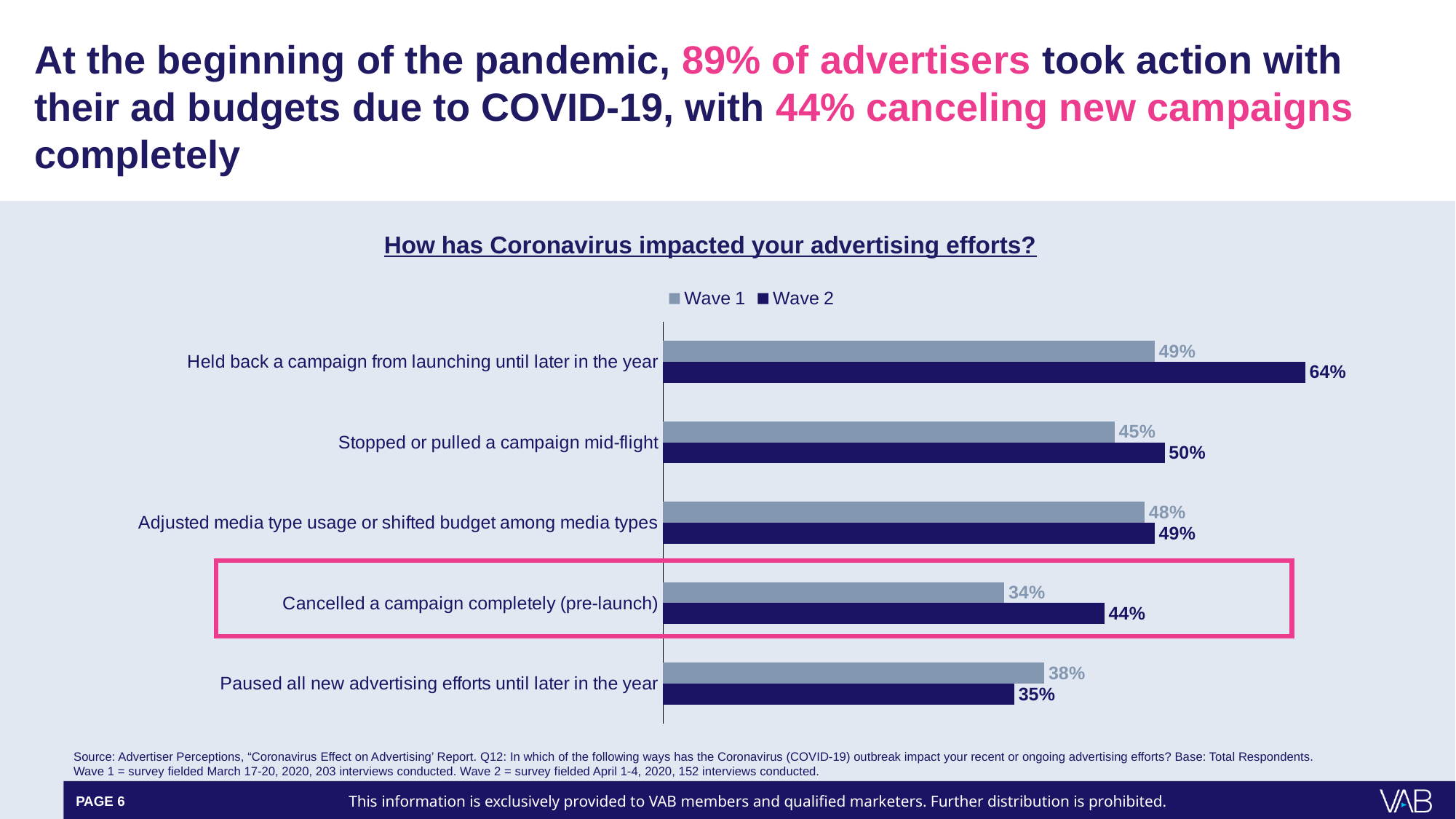
Which category has the highest Wave 2 value? Held back a campaign from launching until later in the year Which category has the lowest Wave 1 value? Cancelled a campaign completely (pre-launch) How many categories are shown in the chart? 5 What is the title of the chart? How has Coronavirus impacted your advertising efforts? What is the Wave 2 value for "Paused all new advertising efforts until later in the year"? 35% Which category is highlighted with a pink box on the chart? Cancelled a campaign completely (pre-launch) What is the Wave 2 value for "Held back a campaign from launching until later in the year"? 64% What is the difference between the Wave 2 and Wave 1 values for "Held back a campaign from launching until later in the year"? 15% How many series does the legend list? 2 What is the Wave 1 value for "Cancelled a campaign completely (pre-launch)"? 34% What kind of chart is shown on the slide? Bar chart For "Paused all new advertising efforts until later in the year", which is larger: the Wave 1 value or the Wave 2 value? Wave 1